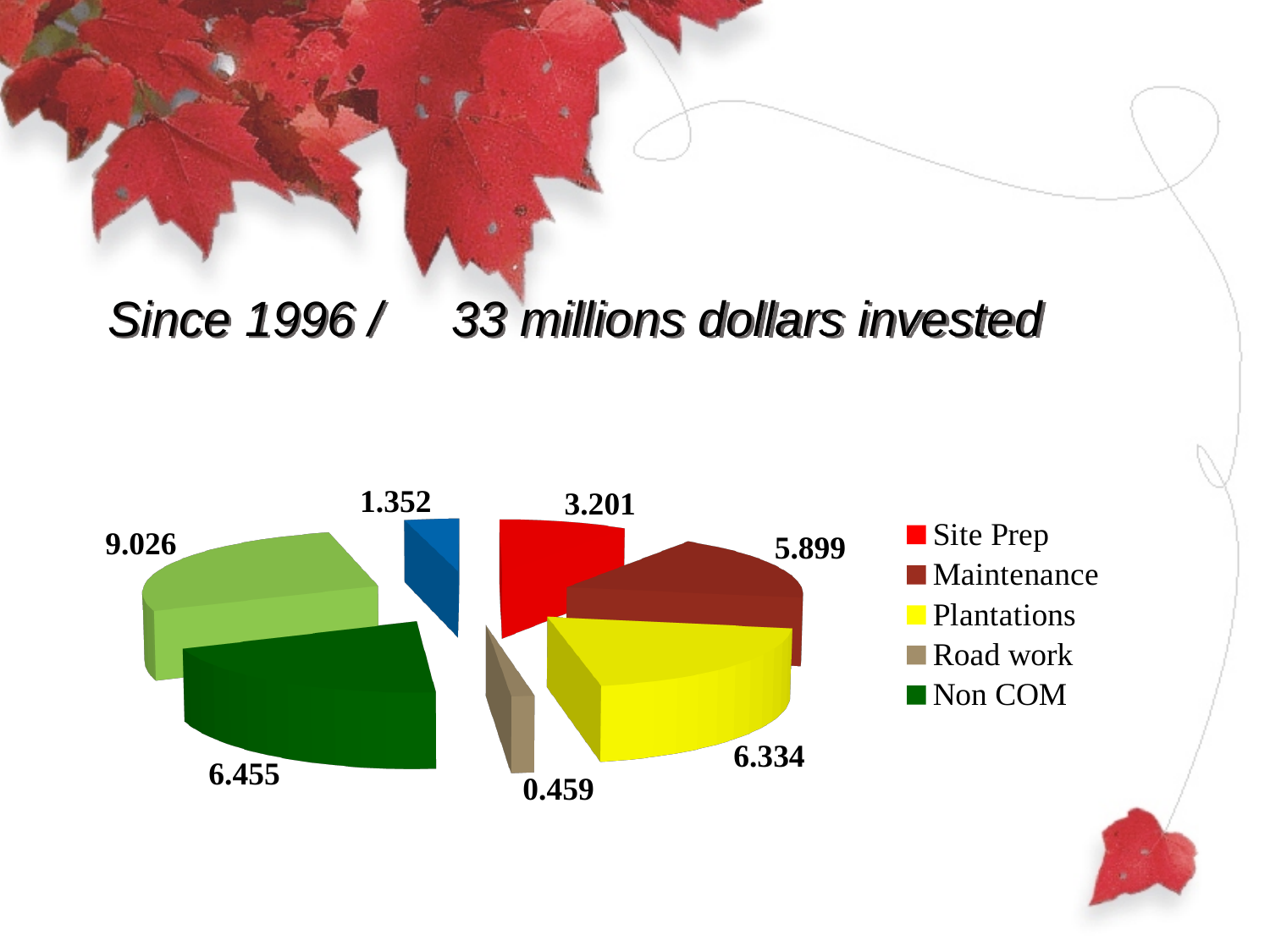
Which legend category has the smallest slice in the pie chart? Road work What is the value of the Non COM slice? 6.455 What is the difference between the Plantations value and the Site Prep value? 3.133 What is the value of the Site Prep slice? 3.201 What is the value of the Plantations slice? 6.334 What is the largest value labelled on the pie chart? 9.026 How many slices does the pie chart have? 7 What is the value of the Road work slice? 0.459 Which is larger, the Plantations slice or the Maintenance slice? Plantations What kind of chart is shown on the slide? pie chart How many entries does the legend list? 5 What is the value of the Maintenance slice? 5.899